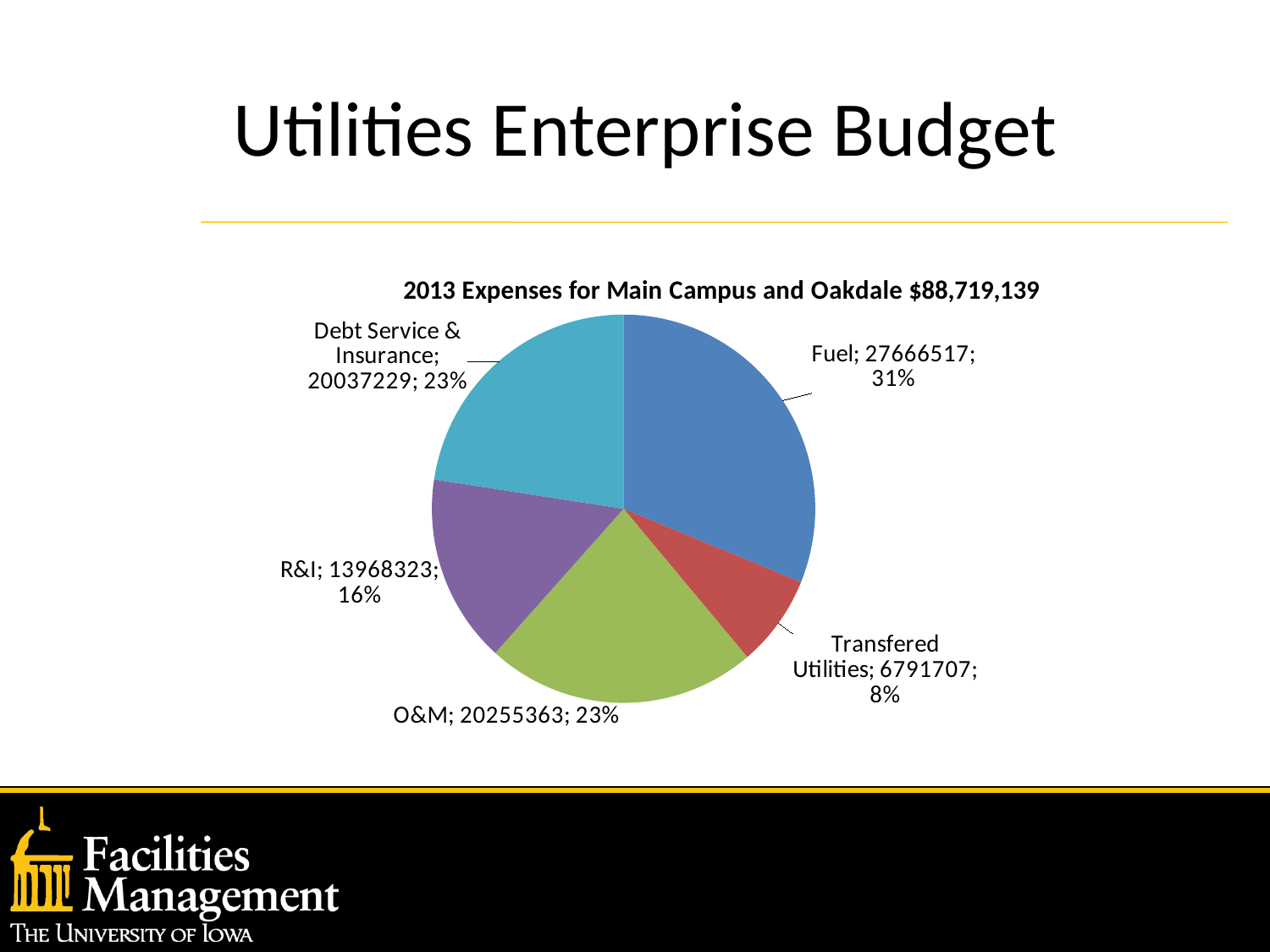
What is the value shown for Transfered Utilities? 6791707 What is the value shown for R&I? 13968323 What is the title of the chart? 2013 Expenses for Main Campus and Oakdale $88,719,139 What type of chart is shown on the slide? pie chart What percentage share of the pie does Debt Service & Insurance represent? 23% Which category has the largest slice of the pie? Fuel Which has the larger value, O&M or Debt Service & Insurance? O&M What is the value shown for Fuel? 27666517 Which category has the smallest slice of the pie? Transfered Utilities What percentage share of the pie does Fuel represent? 31% How many slices does the pie chart have? 5 What is the difference between the Fuel value and the Transfered Utilities value? 20874810